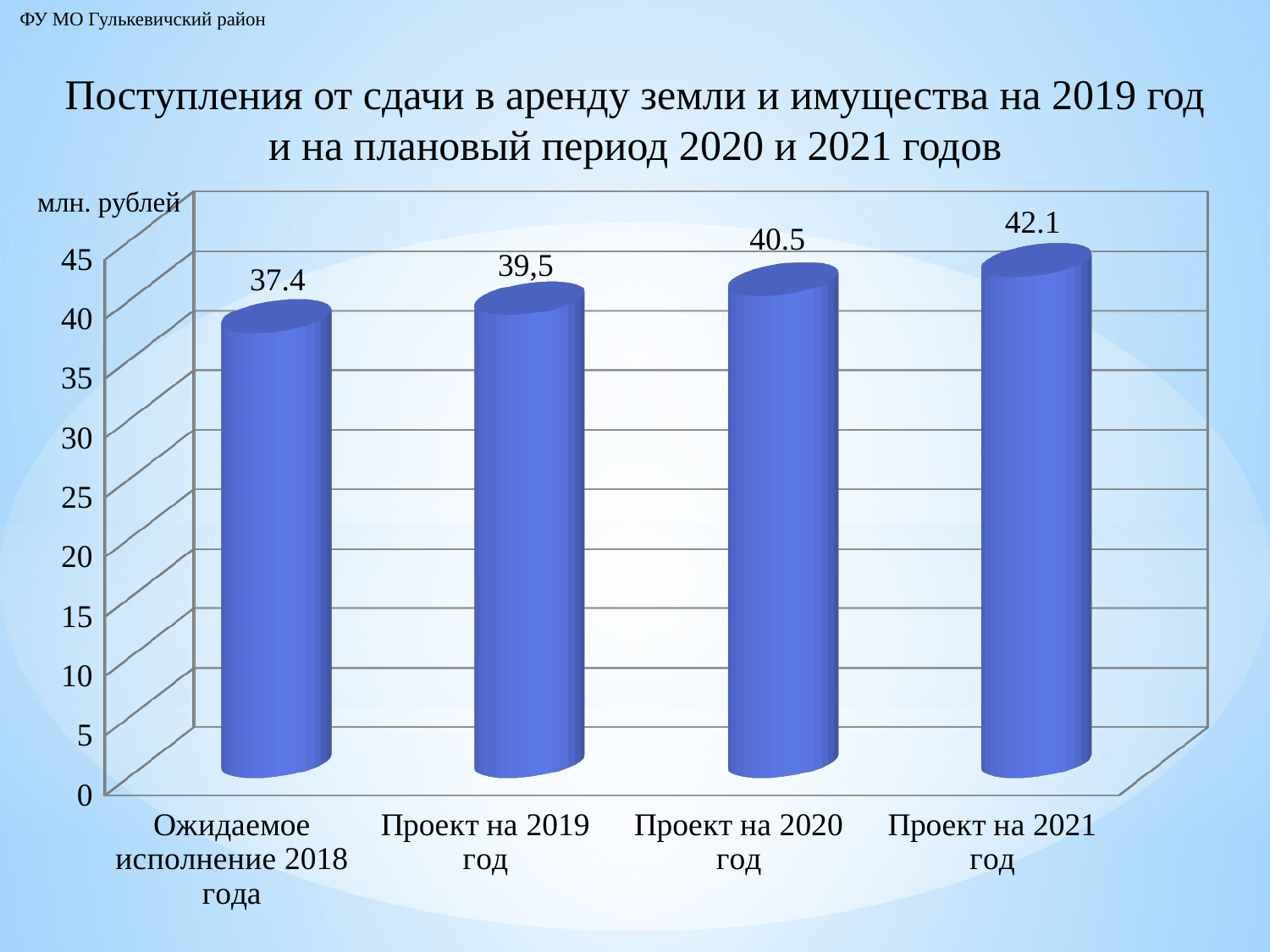
Which is larger, the value for Проект на 2020 год or the value for Проект на 2019 год? Проект на 2020 год What is the difference between the values for Проект на 2021 год and Проект на 2020 год? 1.6 Which category has the highest value? Проект на 2021 год How many categories are shown on the chart? 4 What is the value for Проект на 2020 год? 40.5 Do the values rise or fall from left to right along the x axis? Rise What is the value shown for Проект на 2019 год? 39,5 What kind of chart is shown on the slide? Bar chart What is the difference between the values for Проект на 2021 год and Ожидаемое исполнение 2018 года? 4.7 What is the value for Ожидаемое исполнение 2018 года? 37.4 What is the value for Проект на 2021 год? 42.1 Which category has the lowest value? Ожидаемое исполнение 2018 года